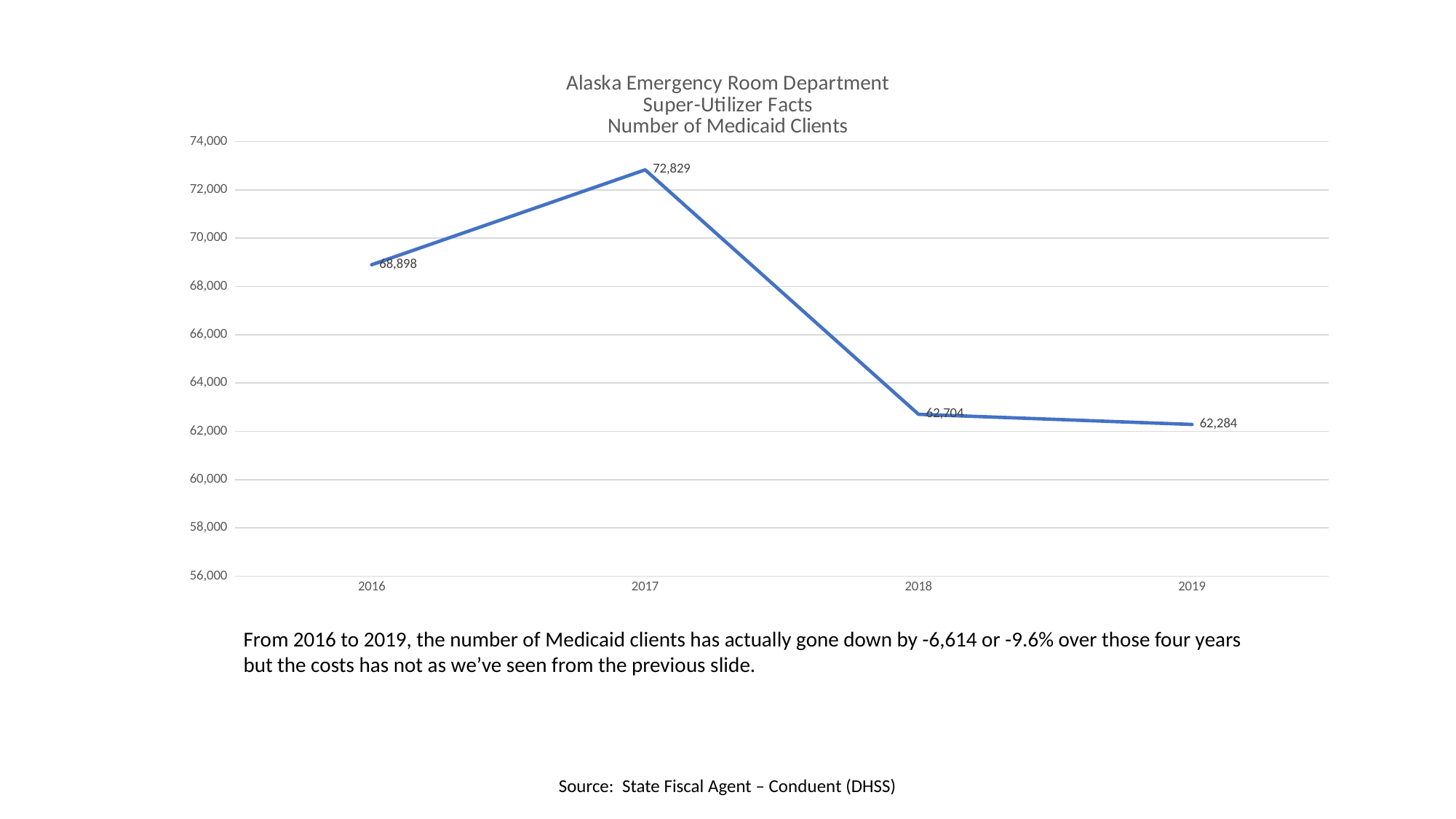
Which year has more Medicaid clients, 2016 or 2018? 2016 What is the number of Medicaid clients in 2019? 62,284 How many years are plotted on the chart? 4 What is the number of Medicaid clients in 2017? 72,829 What is the number of Medicaid clients in 2016? 68,898 What kind of chart is shown on the slide? line chart Which year has the lowest number of Medicaid clients? 2019 What is the difference in the number of Medicaid clients between 2016 and 2019? 6,614 Is the number of Medicaid clients in 2018 greater or less than 64,000? less Which year has the highest number of Medicaid clients? 2017 What is the difference in the number of Medicaid clients between 2017 and 2018? 10,125 Does the number of Medicaid clients rise or fall from 2017 to 2019? fall